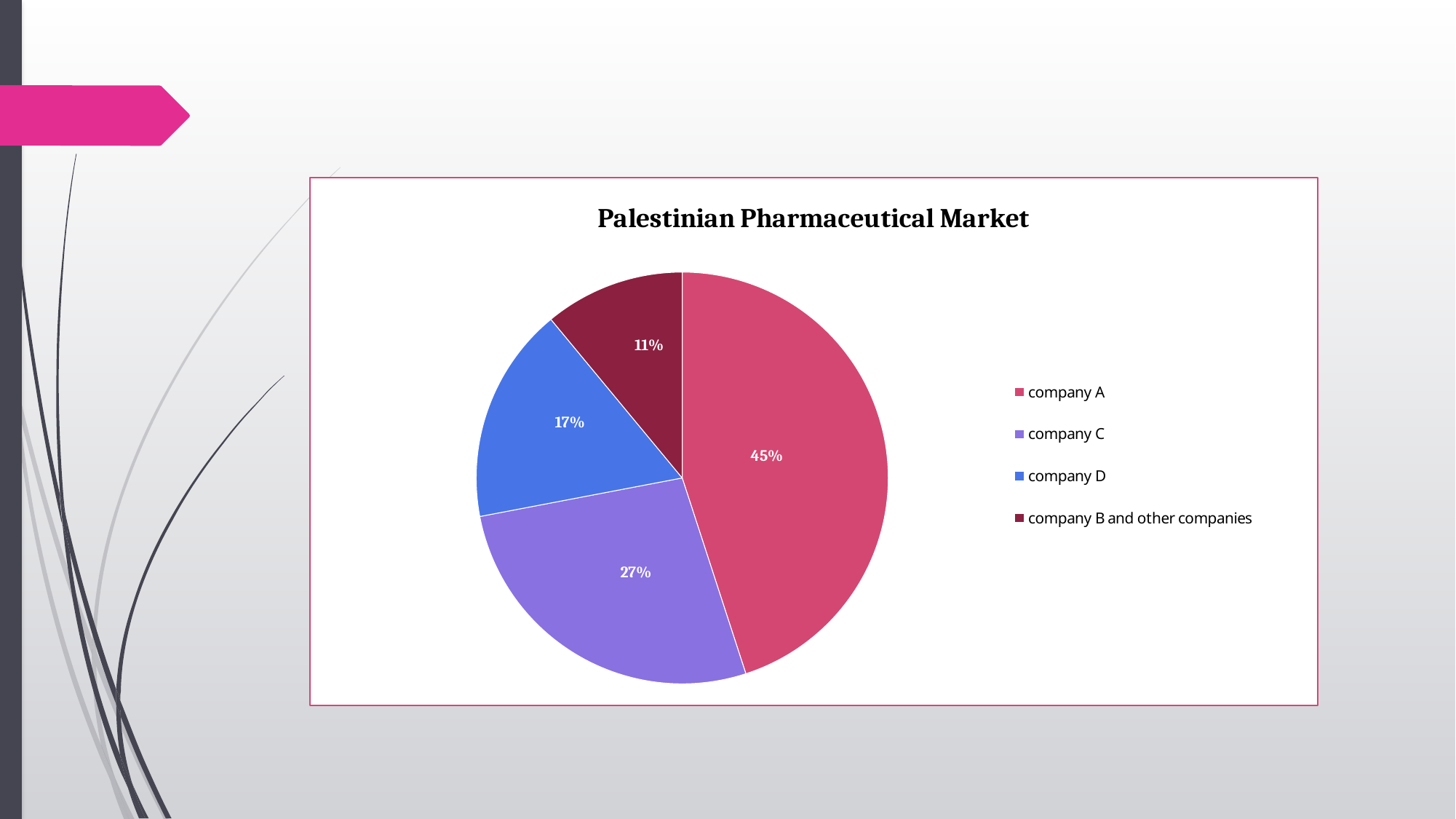
Which company has the largest share of the market? company A What colour is the slice for company D? blue Which has a larger share, company C or company D? company C What share of the market is held by company B and other companies? 11% What is the difference between the shares of company A and company C? 18% How many slices does the pie chart have? 4 What is the title of the chart? Palestinian Pharmaceutical Market Which slice of the pie is the smallest? company B and other companies What share of the market does company C hold? 27% What kind of chart is shown on the slide? pie chart What share of the market does company D hold? 17% What share of the market does company A hold? 45%